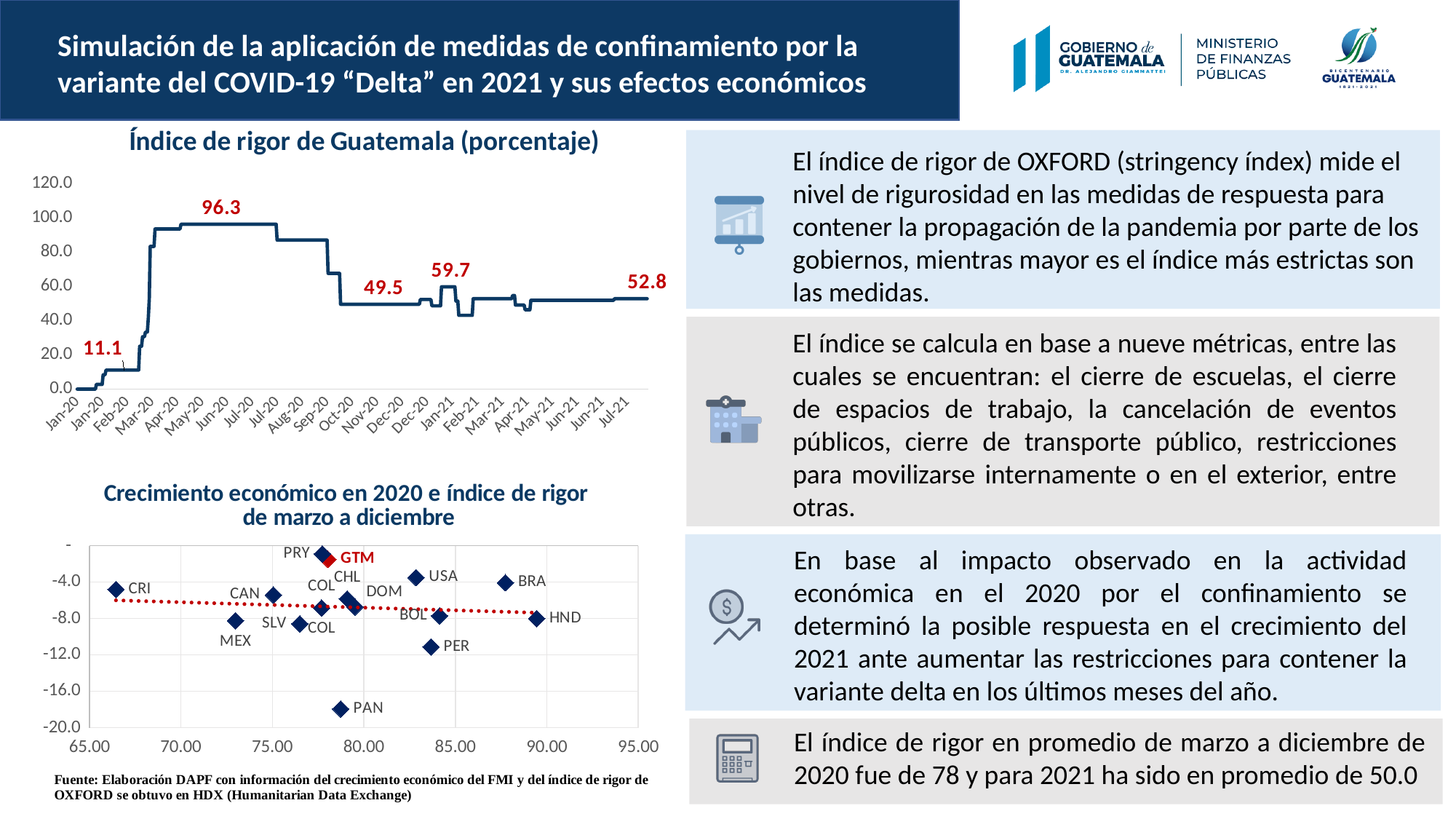
In the 'Crecimiento económico en 2020 e índice de rigor de marzo a diciembre' chart, which country has the higher growth value, BRA or HND? BRA In the 'Índice de rigor de Guatemala (porcentaje)' chart, what is the highest labelled value of the index? 96.3 In the 'Índice de rigor de Guatemala (porcentaje)' chart, is the index value in Apr-20 greater or less than 80.0? greater In the 'Índice de rigor de Guatemala (porcentaje)' chart, what is the value labelled at the start of the series in Jan-20? 11.1 In the 'Índice de rigor de Guatemala (porcentaje)' chart, what is the difference between the labelled values 59.7 and 49.5? 10.2 In the 'Crecimiento económico en 2020 e índice de rigor de marzo a diciembre' chart, which country has the lowest economic growth value? PAN In the 'Índice de rigor de Guatemala (porcentaje)' chart, which labelled value is larger, 59.7 or 49.5? 59.7 What kind of chart is the 'Índice de rigor de Guatemala (porcentaje)' chart? line chart In the 'Índice de rigor de Guatemala (porcentaje)' chart, what is the difference between the peak value 96.3 and the final value 52.8? 43.5 In the 'Crecimiento económico en 2020 e índice de rigor de marzo a diciembre' chart, is the growth value for PAN greater or less than -16.0? less What kind of chart is the 'Crecimiento económico en 2020 e índice de rigor de marzo a diciembre' chart? scatter chart In the 'Índice de rigor de Guatemala (porcentaje)' chart, what is the last labelled value at the end of the series (Jul-21)? 52.8